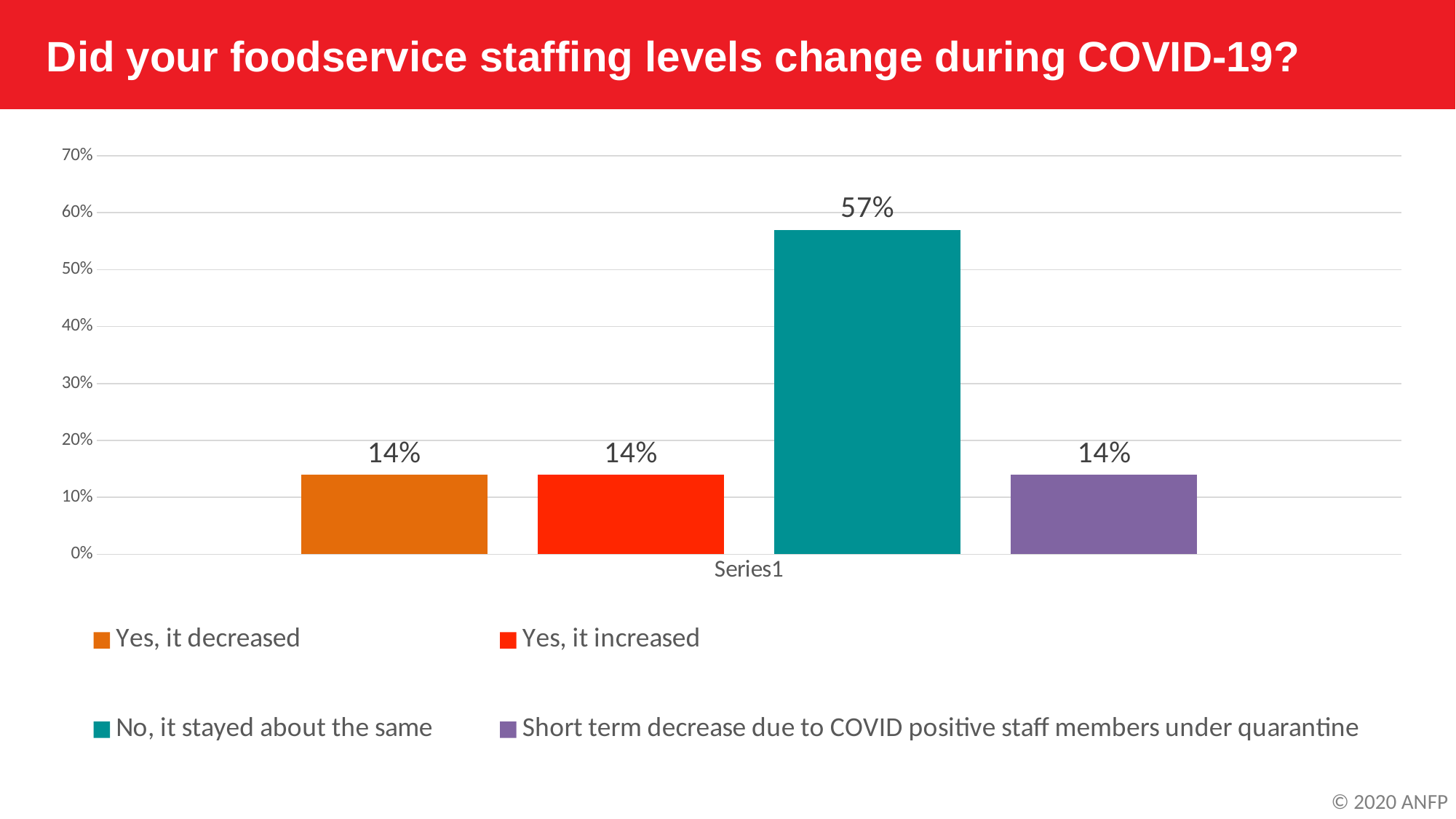
What is the difference in percentage points between 'No, it stayed about the same' and 'Yes, it increased'? 43 What percentage of respondents said their foodservice staffing levels decreased? 14% What percentage of respondents reported a short term decrease due to COVID positive staff members under quarantine? 14% Which is larger: the value for 'No, it stayed about the same' or the value for 'Yes, it decreased'? No, it stayed about the same What type of chart is shown on the slide? Bar chart What colour is the bar for 'No, it stayed about the same'? Teal How many entries does the legend list? 4 Is the value for 'Yes, it increased' greater or less than 20%? less What percentage of respondents said their foodservice staffing levels stayed about the same during COVID-19? 57% How many bars are plotted on the chart? 4 Which response received the highest percentage? No, it stayed about the same Is the value for 'No, it stayed about the same' greater or less than 50%? greater